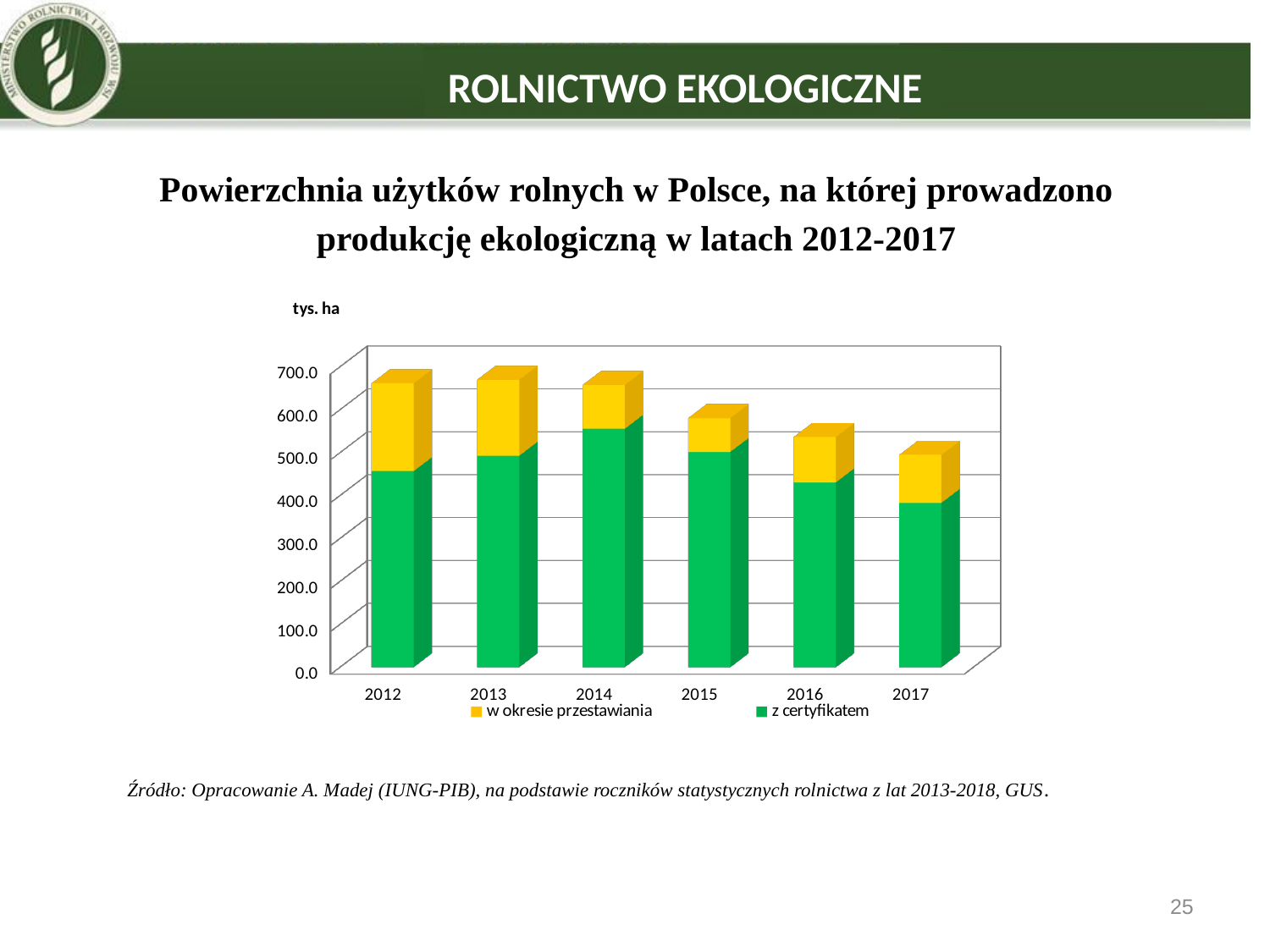
Is the total bar for 2017 greater or less than 600.0? less Is the value for 'z certyfikatem' in 2014 greater or less than 500.0? greater Which year has the lowest total bar in the chart? 2017 Do the total bars rise or fall from 2014 to 2017? fall What kind of chart is shown on the slide? stacked bar chart Which year has the lowest value for 'z certyfikatem'? 2017 How many years are shown on the x axis of the chart? 6 How many series does the chart legend list? 2 Which series is shown in green in the chart? z certyfikatem What unit is given for the y axis of the chart? tys. ha Which year has the highest value for 'z certyfikatem'? 2014 Is the total bar for 2012 greater or less than 600.0? greater